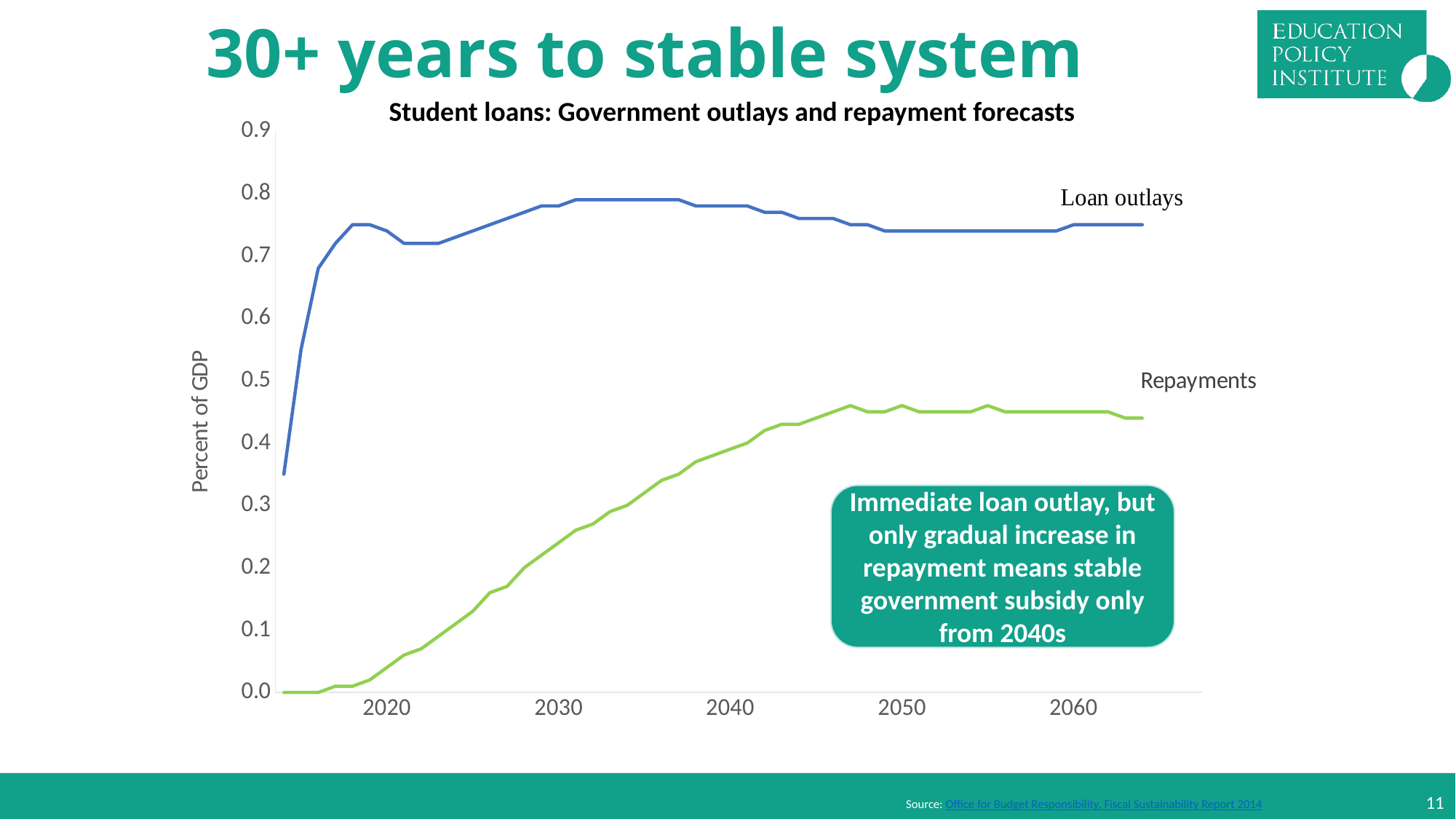
Is the value for Repayments in 2020 greater or less than 0.1? less What is the title of the chart? Student loans: Government outlays and repayment forecasts Is the value for Repayments in 2040 greater or less than 0.3? greater In 2040, which series has the higher value, Loan outlays or Repayments? Loan outlays Do the Repayments values rise or fall between 2020 and 2040? Rise Is the value for Repayments in 2050 greater or less than 0.4? greater What kind of chart is shown on the slide? Line chart What is the label on the vertical axis of the chart? Percent of GDP How many series are plotted on the chart? 2